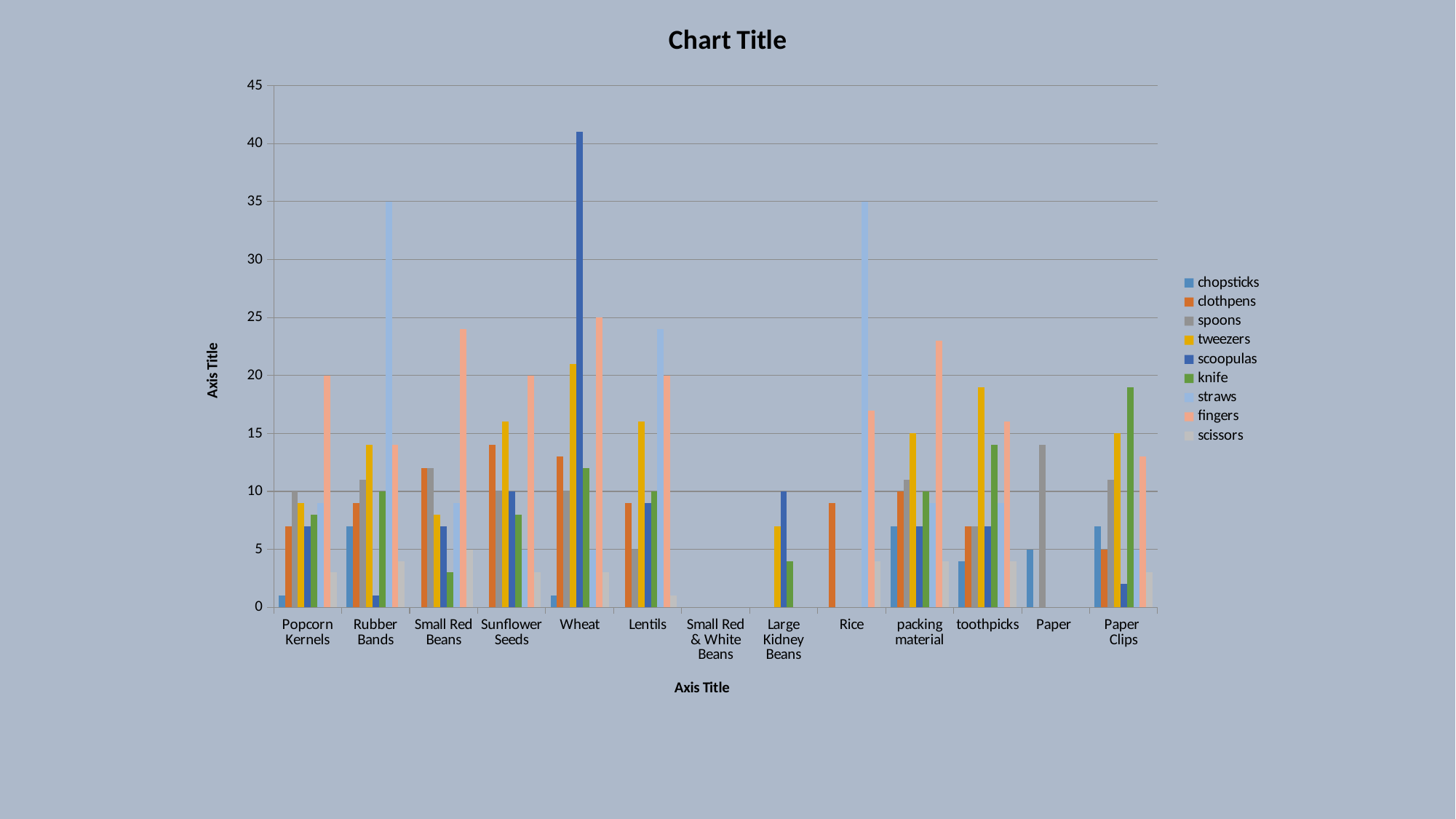
How many categories are shown along the x axis? 13 How many series does the legend list? 9 Is the value for scoopulas at Wheat greater or less than 40? greater What kind of chart is shown on the slide? bar chart Is the value for clothpens at Rice greater or less than 10? less Which series has the tallest bar for Wheat? scoopulas Is the value for fingers at Small Red Beans greater or less than 20? greater Which is larger: the value for tweezers at toothpicks or the value for tweezers at Lentils? toothpicks What is the title of the chart? Chart Title Which category contains the tallest bar in the chart? Wheat What is the value for fingers at Wheat? 25